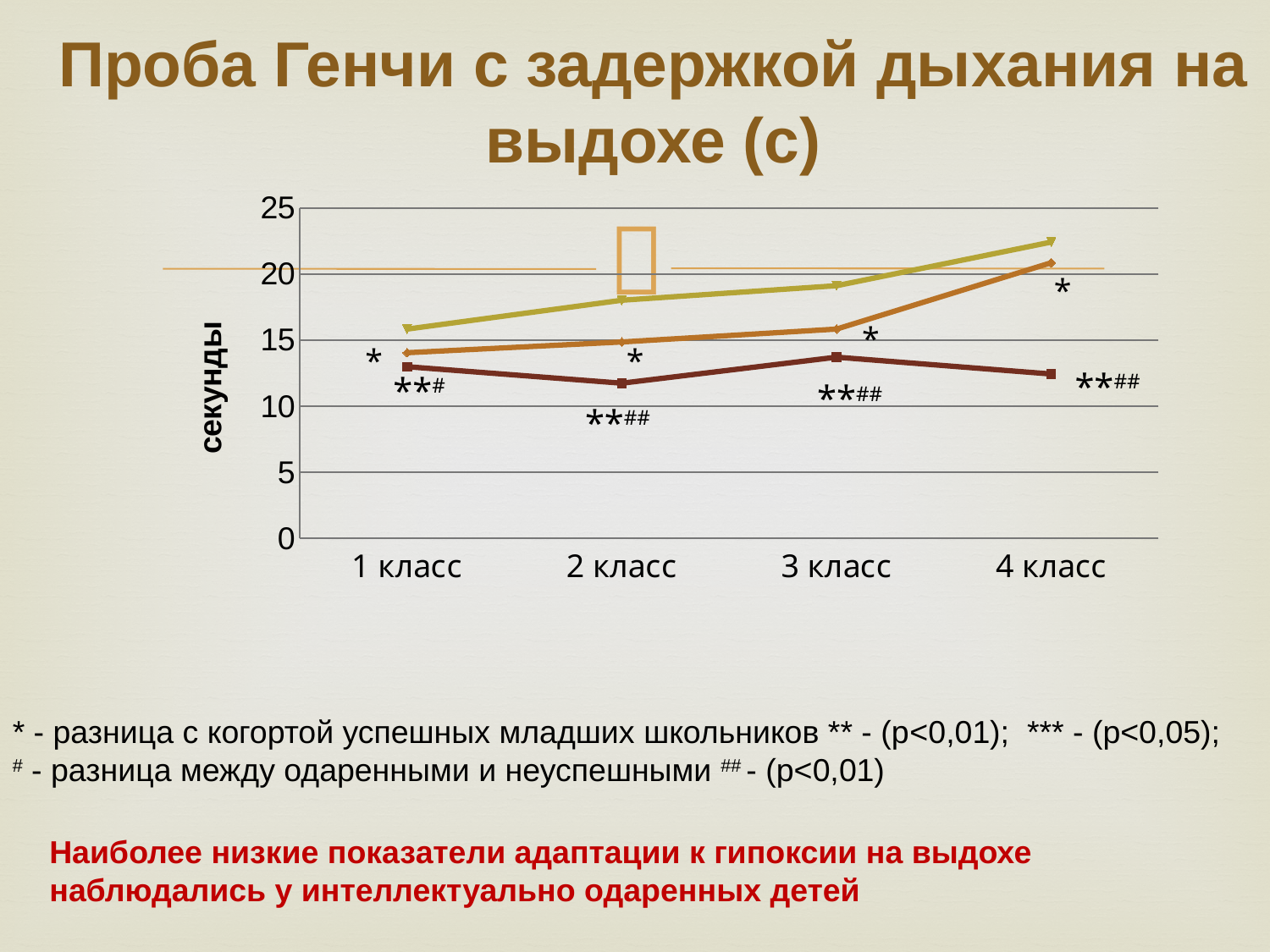
Is the value of the dark brown line for 4 класс greater or less than 15? less What kind of chart is shown on the slide? line chart How many categories (classes) are shown on the x axis of the chart? 4 How many lines are plotted on the chart? 3 Does the yellow-green line rise or fall from 1 класс to 4 класс? rises Is the value of the dark brown line for 1 класс greater or less than 15? less For 4 класс, which line has the larger value: the yellow-green line or the dark brown line? the yellow-green line For which class does the yellow-green line reach its highest value? 4 класс Is the value of the yellow-green line for 2 класс greater or less than 20? less What is the label of the vertical axis of the chart? секунды What is the title of the chart on the slide? Проба Генчи с задержкой дыхания на выдохе (с)